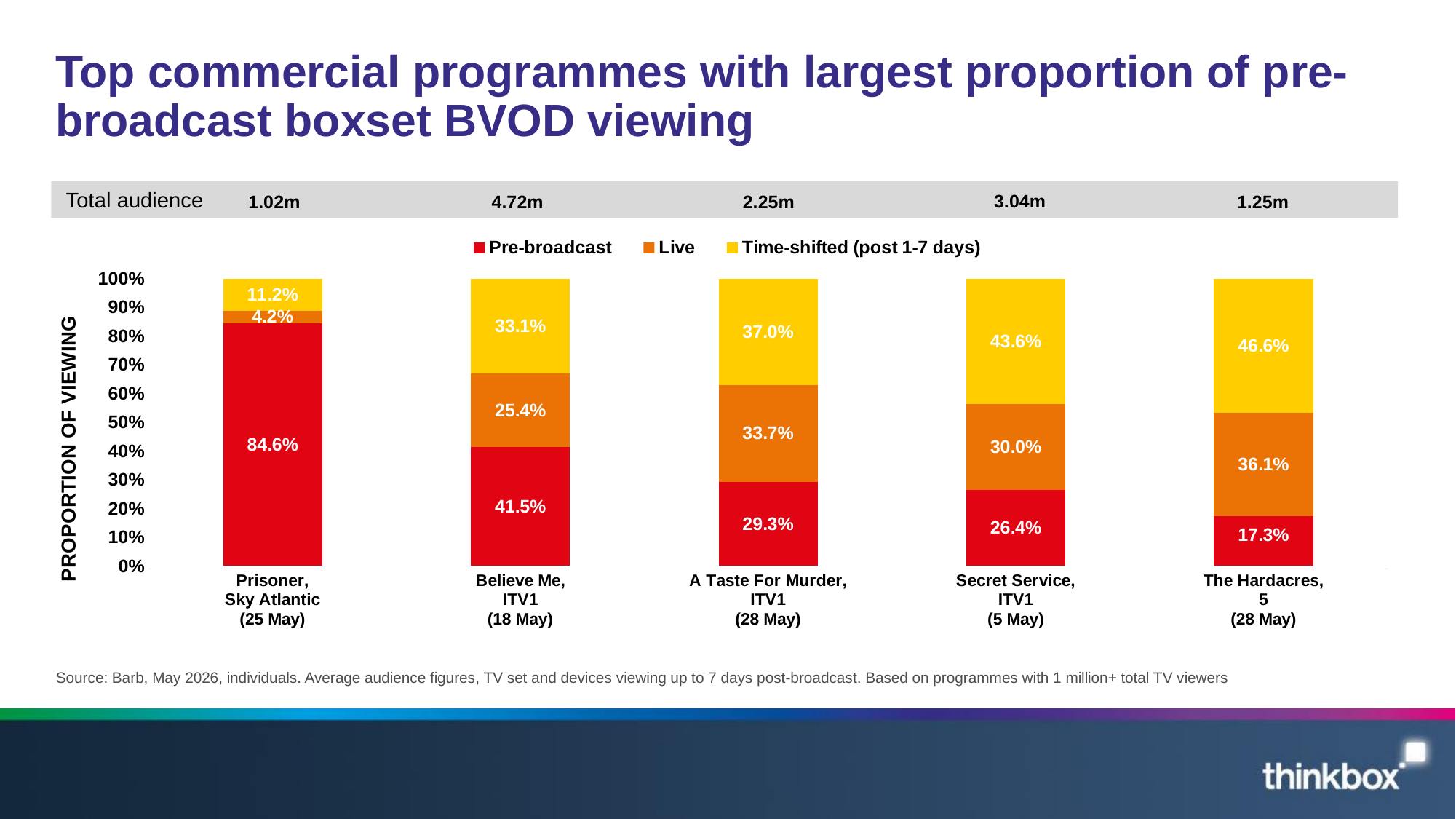
What is the Live proportion of viewing for A Taste For Murder, ITV1 (28 May)? 33.7% Which programme has the highest Pre-broadcast proportion of viewing? Prisoner, Sky Atlantic (25 May) What is the Pre-broadcast proportion of viewing for Prisoner, Sky Atlantic (25 May)? 84.6% Which programme has the lowest Live proportion of viewing? Prisoner, Sky Atlantic (25 May) What is the Time-shifted (post 1-7 days) proportion of viewing for Secret Service, ITV1 (5 May)? 43.6% How many programmes are shown on the x axis of the chart? 5 Which is larger: the Live proportion for The Hardacres, 5 or the Live proportion for Secret Service, ITV1? The Hardacres, 5 What is the difference in Pre-broadcast proportion between Prisoner, Sky Atlantic and Believe Me, ITV1? 43.1 percentage points Which programme has the highest Time-shifted (post 1-7 days) proportion of viewing? The Hardacres, 5 (28 May) What type of chart is shown on the slide? Stacked bar chart How many series does the chart legend list? 3 Does the Pre-broadcast proportion of viewing rise or fall moving from left to right across the programmes? Fall